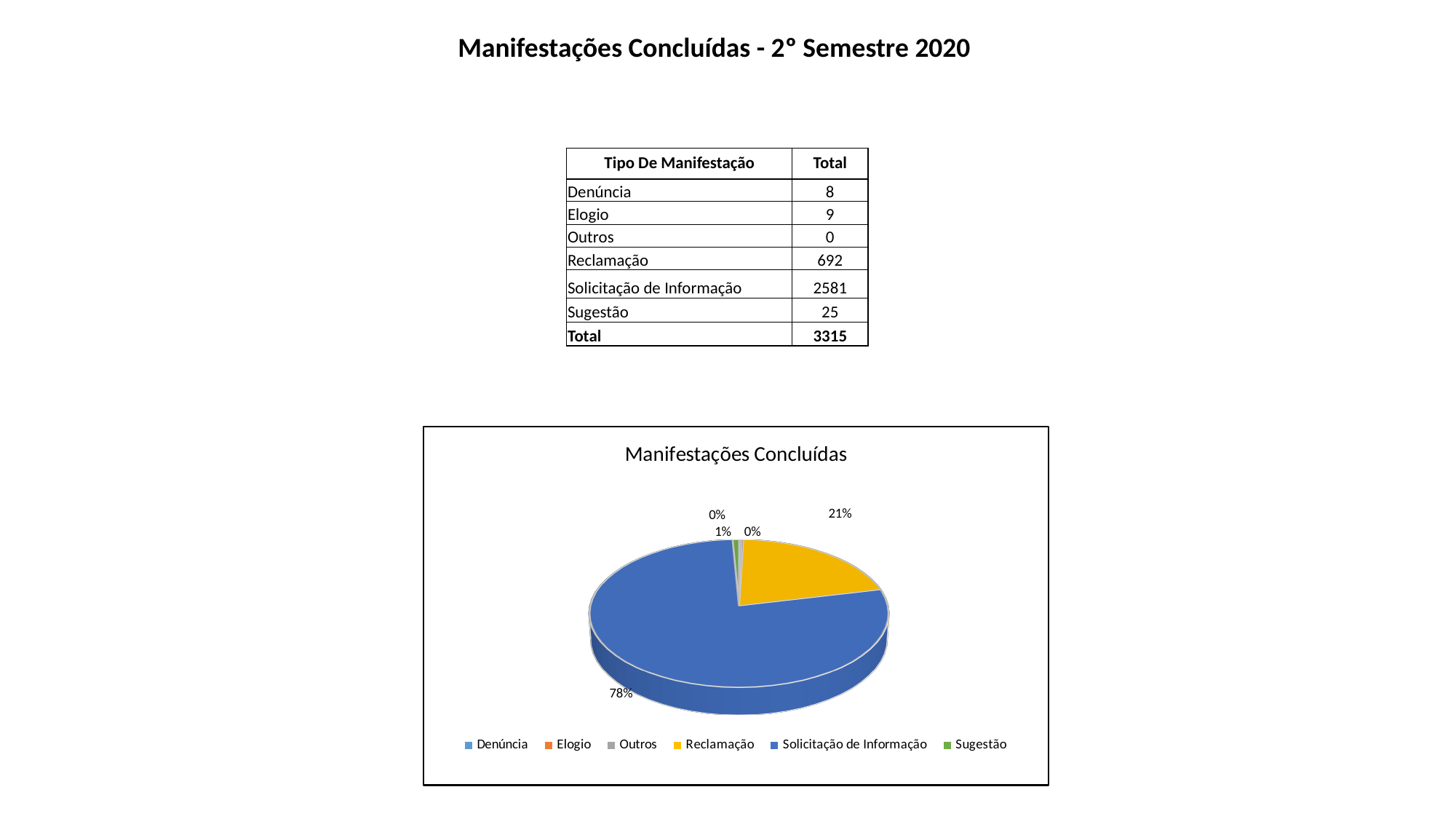
Which slice is larger, Reclamação or Sugestão? Reclamação By how many percentage points does the Solicitação de Informação share exceed the Reclamação share? 57 What kind of chart is shown on the slide? pie chart How many categories does the chart's legend list? 6 What colour is the Reclamação slice in the pie chart? yellow What is the title of the chart? Manifestações Concluídas Is the share for Solicitação de Informação greater or less than 50%? greater What share of the pie does Sugestão represent? 1% Which category has the largest slice of the pie? Solicitação de Informação What share of the pie does Solicitação de Informação represent? 78% Which slice is larger, Reclamação or Solicitação de Informação? Solicitação de Informação What share of the pie does Reclamação represent? 21%